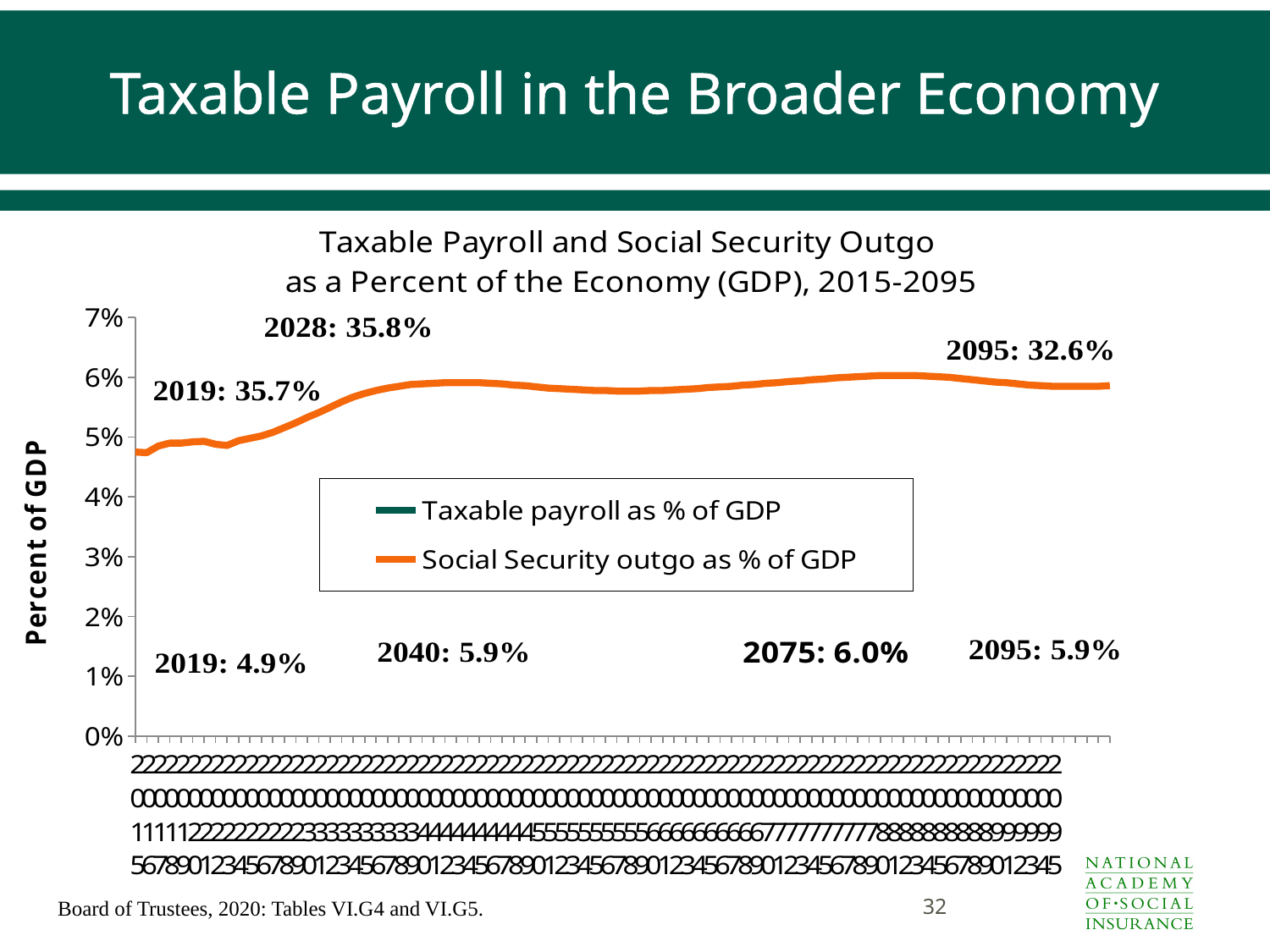
How many series does the legend list? 2 What kind of chart is shown on the slide? line chart What is the labelled value of Social Security outgo as % of GDP in 2019? 4.9% What is the labelled value of Social Security outgo as % of GDP in 2075? 6.0% What is the labelled value of taxable payroll as % of GDP in 2028? 35.8% What is the title of the chart? Taxable Payroll and Social Security Outgo as a Percent of the Economy (GDP), 2015-2095 Which is larger: the labelled taxable payroll value in 2019 or in 2095? 2019 Does the Social Security outgo line rise or fall between 2019 and 2040? rise What is the labelled value of Social Security outgo as % of GDP in 2095? 5.9% Is the Social Security outgo as % of GDP in 2040 greater or less than 5%? greater By how many percentage points does the labelled Social Security outgo value in 2075 exceed the labelled value in 2019? 1.1 percentage points What is the labelled value of taxable payroll as % of GDP in 2095? 32.6%